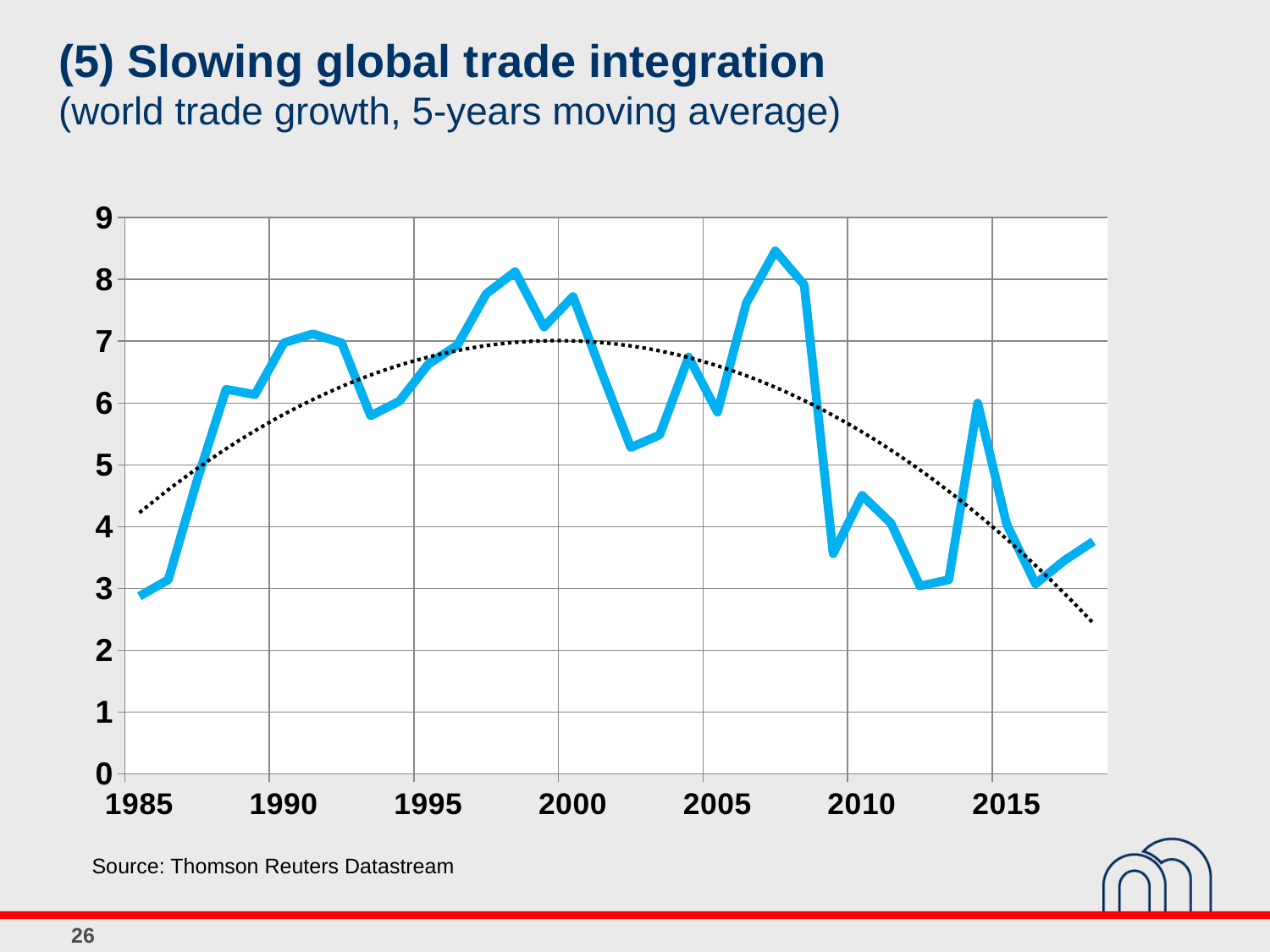
Does the blue line rise or fall between 2007 and 2009? fall Is the value of the blue line in 1998 greater or less than 7? greater What is the source cited below the chart? Thomson Reuters Datastream Does the dotted trend line rise or fall between 2010 and 2018? fall Does the blue line rise or fall between 1985 and 1990? rise Is the value of the blue line in 1990 greater or less than 6? greater What kind of chart is shown on the slide? line chart Is the value of the blue line in 2009 greater or less than 4? less